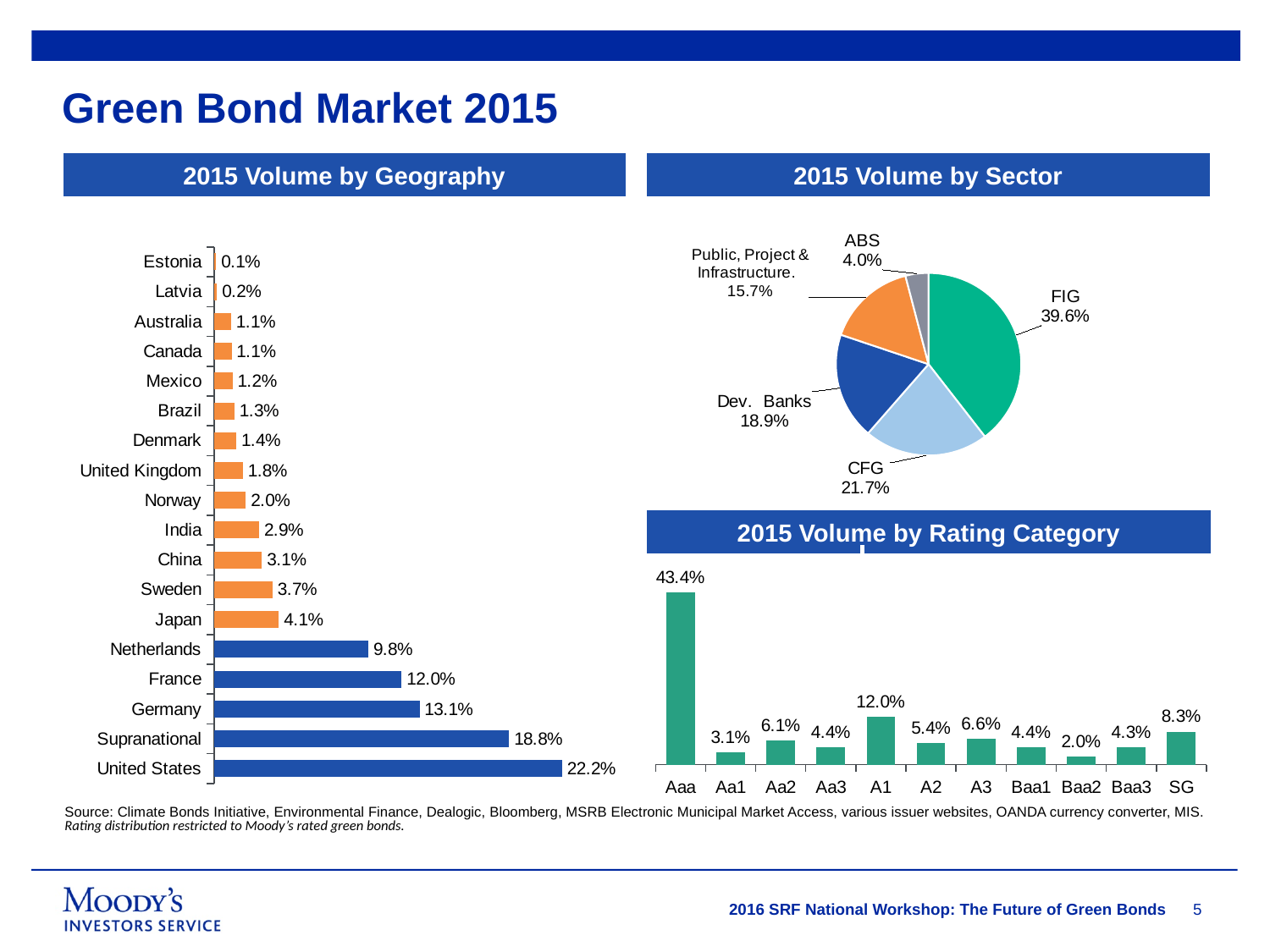
In the '2015 Volume by Sector' chart, which sector has the smallest slice? ABS In the '2015 Volume by Geography' chart, what is the difference between the values for United States and Supranational? 3.4% In the '2015 Volume by Rating Category' chart, which rating category has the highest value? Aaa In the '2015 Volume by Rating Category' chart, what is the difference between the values for A3 and Baa2? 4.6% In the '2015 Volume by Geography' chart, how many categories are shown? 18 In the '2015 Volume by Geography' chart, what is the value for Germany? 13.1% In the '2015 Volume by Rating Category' chart, what is the value for A1? 12.0% What kind of chart is the '2015 Volume by Sector' chart? Pie chart In the '2015 Volume by Sector' chart, what share does FIG have? 39.6% In the '2015 Volume by Geography' chart, which category has the lowest value? Estonia In the '2015 Volume by Geography' chart, which country has the highest value? United States In the '2015 Volume by Geography' chart, which is larger, the value for France or the value for Netherlands? France